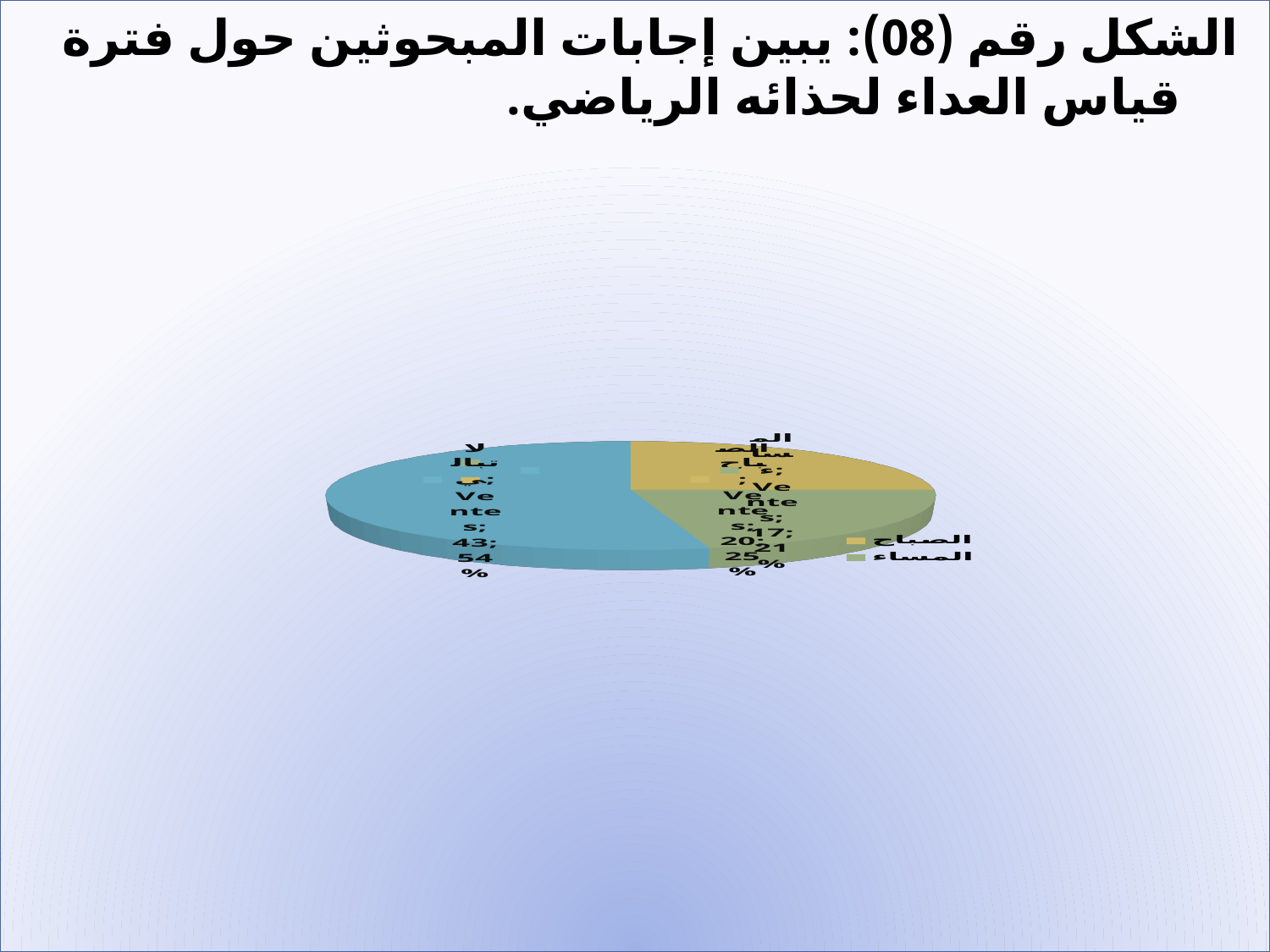
Which slice of the pie chart is the largest? لا تبالي What is the figure number given in the slide title? 08 Is the share for the slice لا يبالي greater or less than 50%? greater Which is larger, the slice for لا يبالي or the slice for المساء? لا تبالي Which is larger, the slice for لا يبالي or the slice for الصباح? لا تبالي What share of the pie does the slice labelled لا يبالي represent? 54% What colour is the slice for لا يبالي in the pie chart? blue What kind of chart is shown on the slide? pie chart What is the value shown for the slice labelled لا يبالي? 43 How many slices does the pie chart have? 3